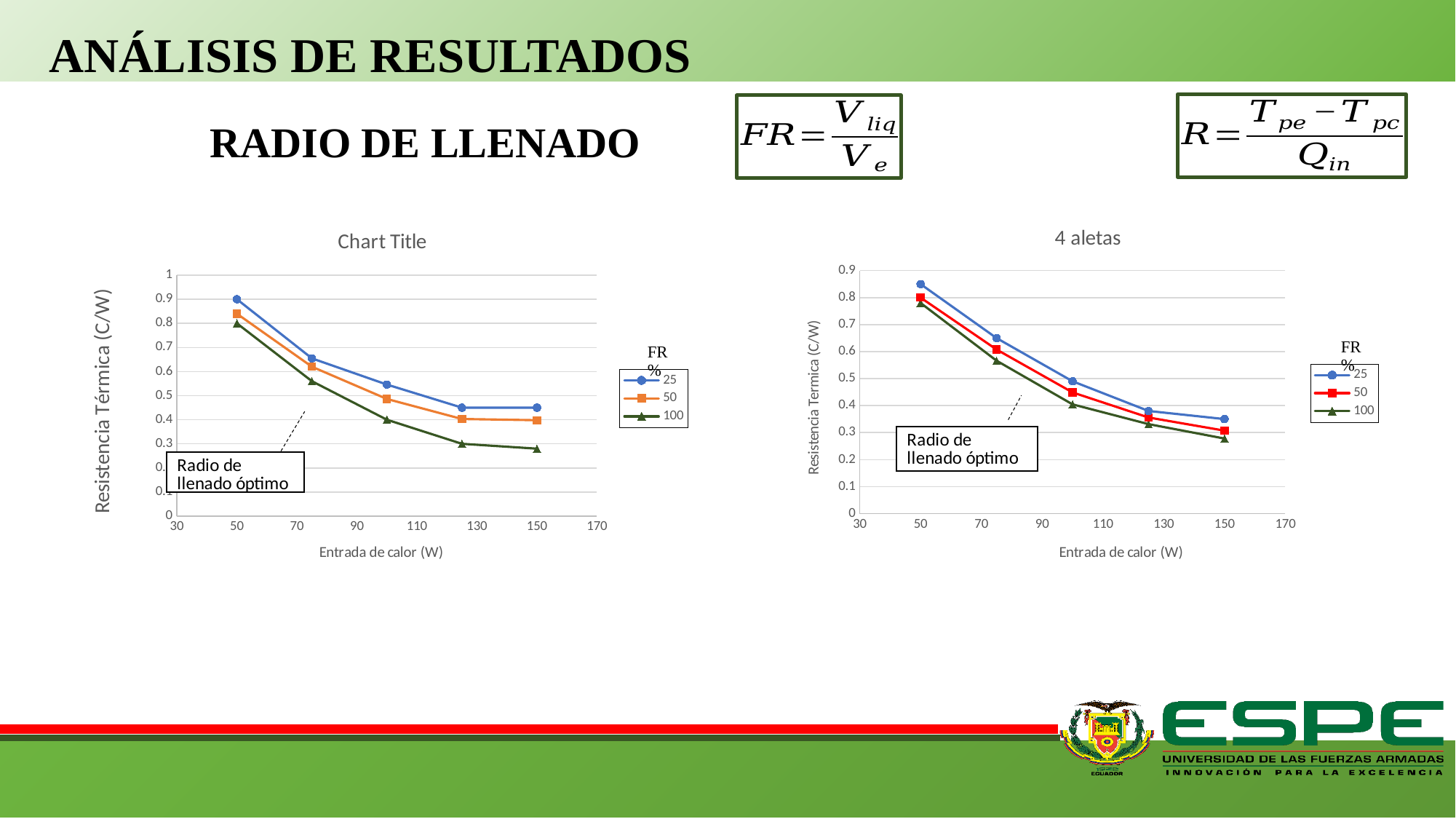
In the left chart titled "Chart Title", at 100 W, which series has the larger value: FR 25 or FR 100? 25 In the left chart titled "Chart Title", is the value of the FR 100 series at 150 W greater or less than 0.3? less In the left chart titled "Chart Title", how many data points does the FR 25 series have? 5 In the left chart titled "Chart Title", which series has the lowest value at 150 W? 100 What kind of chart is the left chart titled "Chart Title"? line chart What is the title of the right chart? 4 aletas In the right chart titled "4 aletas", at 75 W, which series has the larger value: FR 25 or FR 100? 25 In the left chart titled "Chart Title", do the values of the FR 25 series rise or fall as Entrada de calor increases? fall In the left chart titled "Chart Title", how many series does the legend list? 3 In the right chart titled "4 aletas", do the values of the FR 50 series rise or fall as Entrada de calor increases? fall In the right chart titled "4 aletas", is the value of the FR 25 series at 50 W greater or less than 0.8? greater In the left chart titled "Chart Title", is the value of the FR 25 series at 50 W greater or less than 0.8? greater